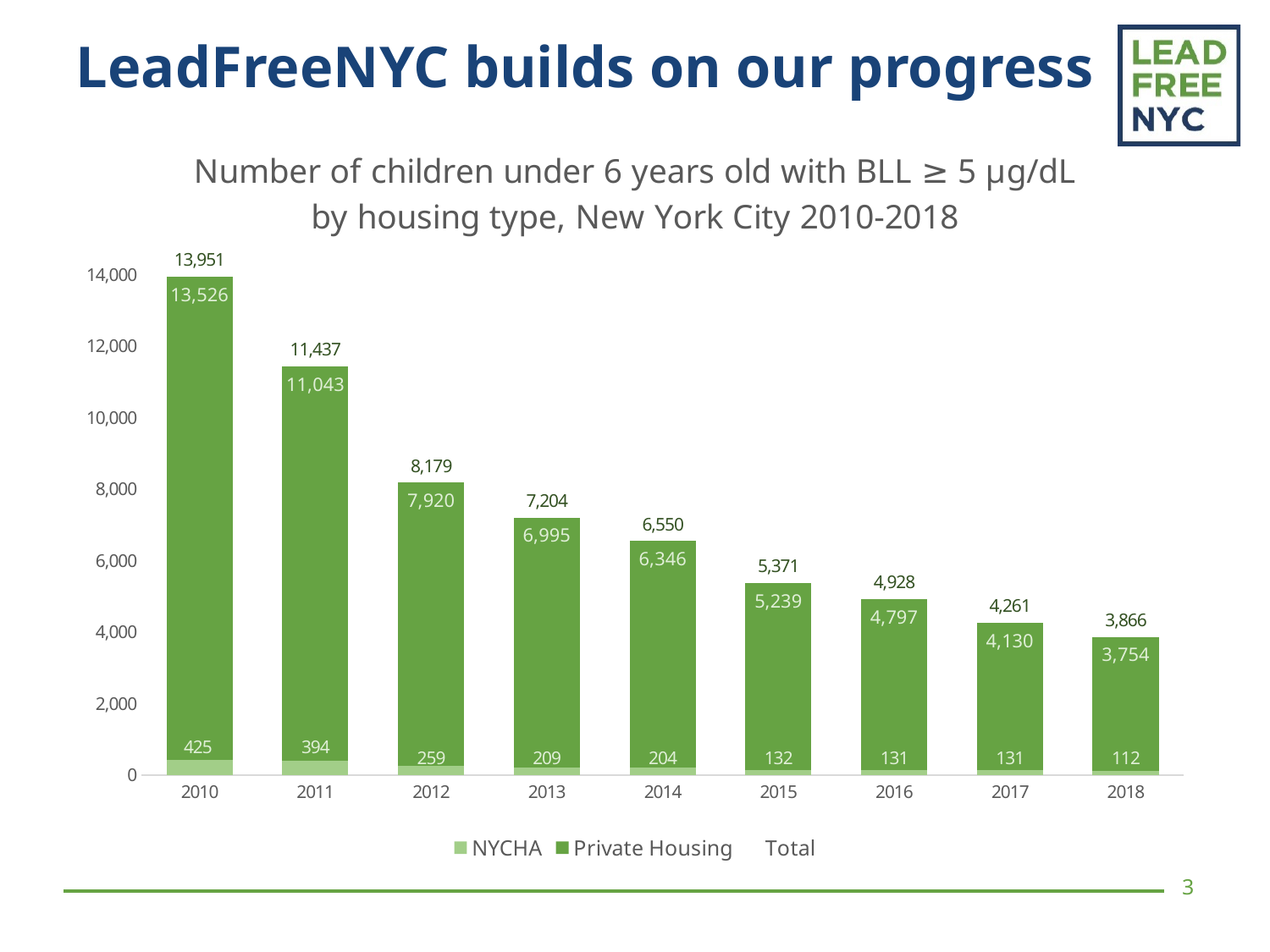
What is the difference between the Total for 2010 and the Total for 2011? 2,514 Do the Total values rise or fall from 2010 to 2018? fall What is the Private Housing value for 2012? 7,920 Which is larger, the Private Housing value for 2014 or for 2015? 2014 What is the NYCHA value for 2010? 425 Is the Total for 2013 greater or less than 8,000? less Which year has the highest Total? 2010 How many years are shown on the x axis? 9 What is the Total value shown for 2018? 3,866 What kind of chart is shown on the slide? stacked bar chart How many entries does the legend list? 3 Which year has the lowest NYCHA value? 2018